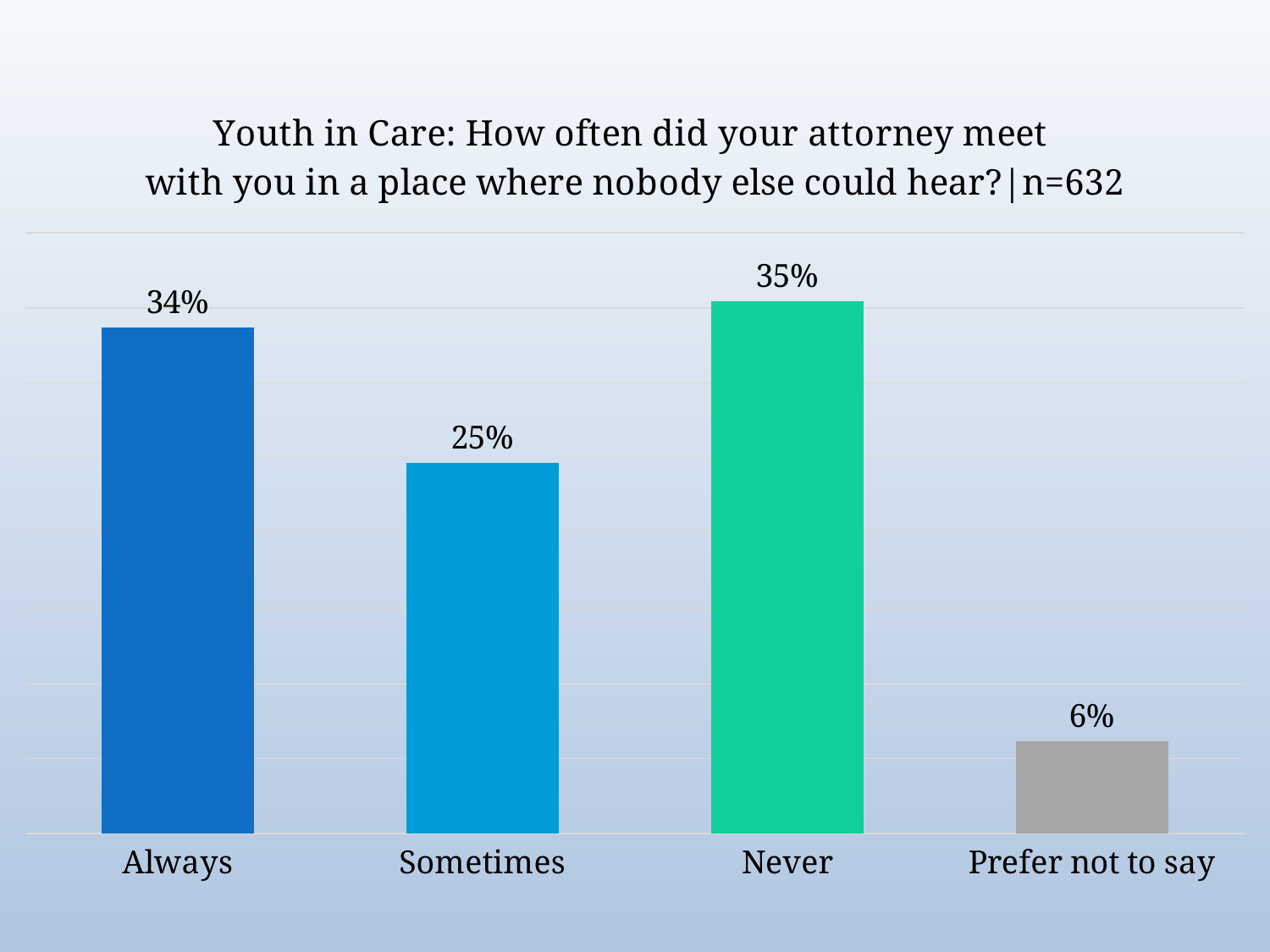
What percentage of youth in care answered "Sometimes"? 25% What is the difference in percentage points between "Always" and "Prefer not to say"? 28 Which response category has the lowest percentage? Prefer not to say Which is larger, the value for "Always" or the value for "Sometimes"? Always What kind of chart is shown on the slide? Bar chart What percentage of youth in care answered "Prefer not to say"? 6% Which is larger, the value for "Sometimes" or the value for "Prefer not to say"? Sometimes How many response categories are shown in the chart? 4 What percentage of youth in care answered "Always"? 34% What percentage of youth in care answered "Never"? 35% What is the difference in percentage points between "Never" and "Sometimes"? 10 What is the sample size (n) given in the chart title? 632